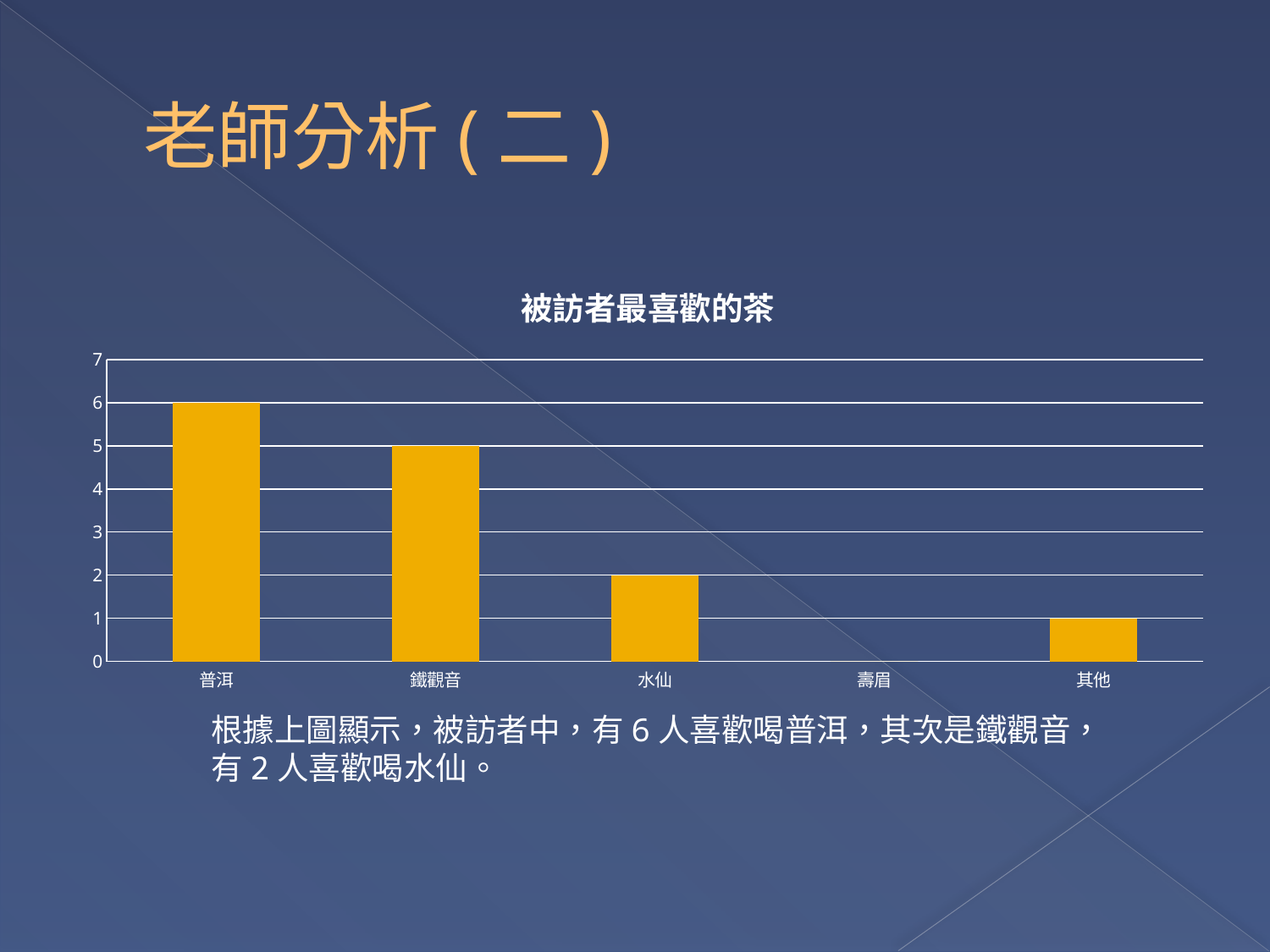
What is the title of the chart? 被訪者最喜歡的茶 Which category has the lowest value? 壽眉 Which category has the highest value? 普洱 What is the value for 鐵觀音? 5 What is the difference between the values for 普洱 and 水仙? 4 Is the value for 鐵觀音 greater or less than 3? greater Which is larger, the value for 鐵觀音 or the value for 其他? 鐵觀音 What is the value for 水仙? 2 What is the value for 其他? 1 How many categories are shown on the x axis of the chart? 5 What type of chart is shown on the slide? bar chart What is the value for 普洱? 6